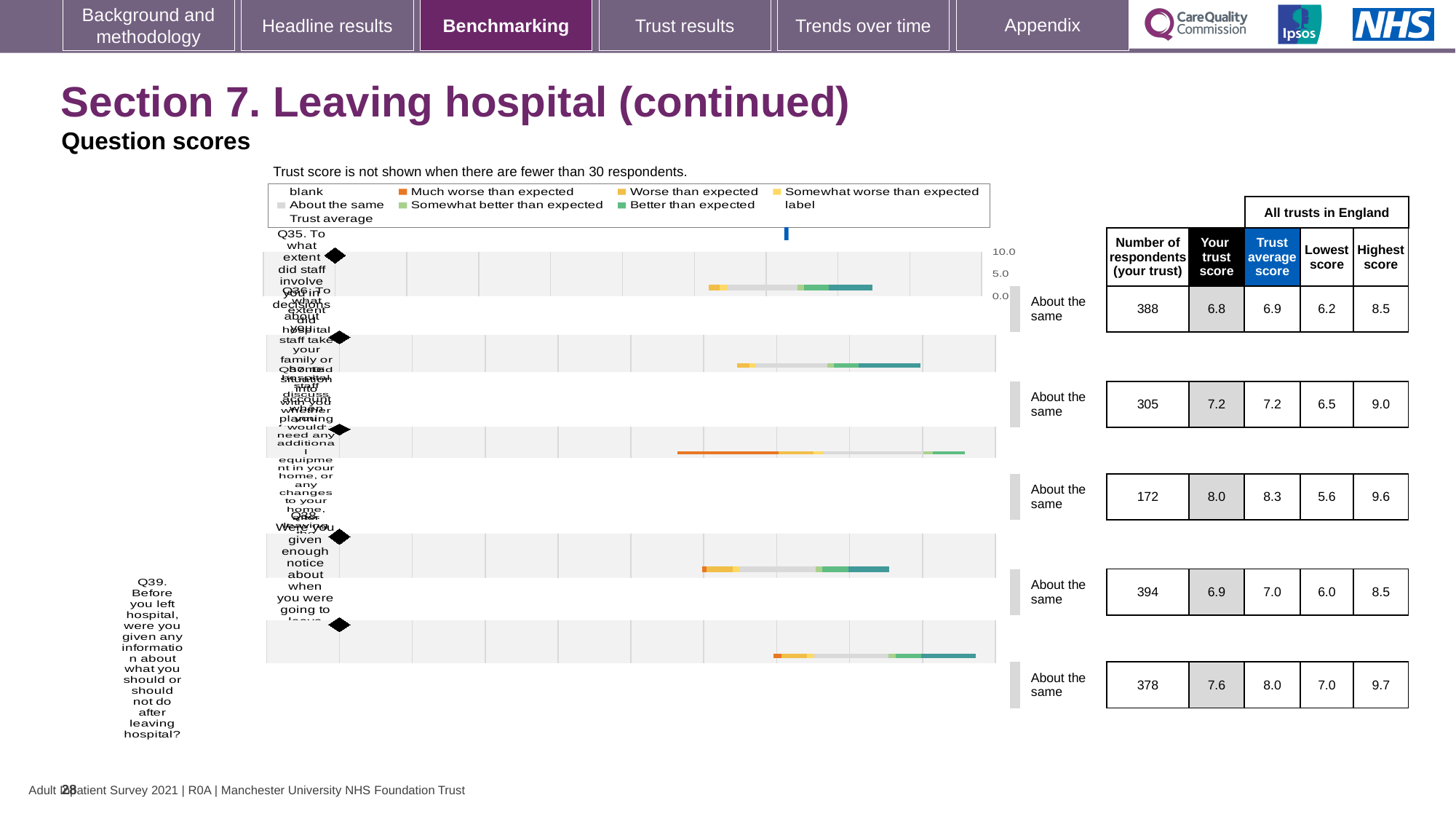
What is the smallest value in the 'Lowest score' column of the table? 5.6 What kind of chart is used to show the question scores on this slide? bar chart How many question rows (bars) are plotted in the chart? 5 What is the largest 'Your trust score' value shown in the table? 8.0 For Q39 (the bottom row), which is larger: your trust score or the trust average score? Trust average score What benchmark category label is shown next to every question row in the chart? About the same What is the 'Trust average score' for Q39 (the bottom row)? 8.0 For Q39 (the bottom row), what is the difference between the trust average score and your trust score? 0.4 What is the 'Highest score' for the first row (Q35) in the table? 8.5 What is 'Your trust score' for Q39 (the bottom row) in the table? 7.6 In the table, what is the number of respondents for Q39 (the bottom row)? 378